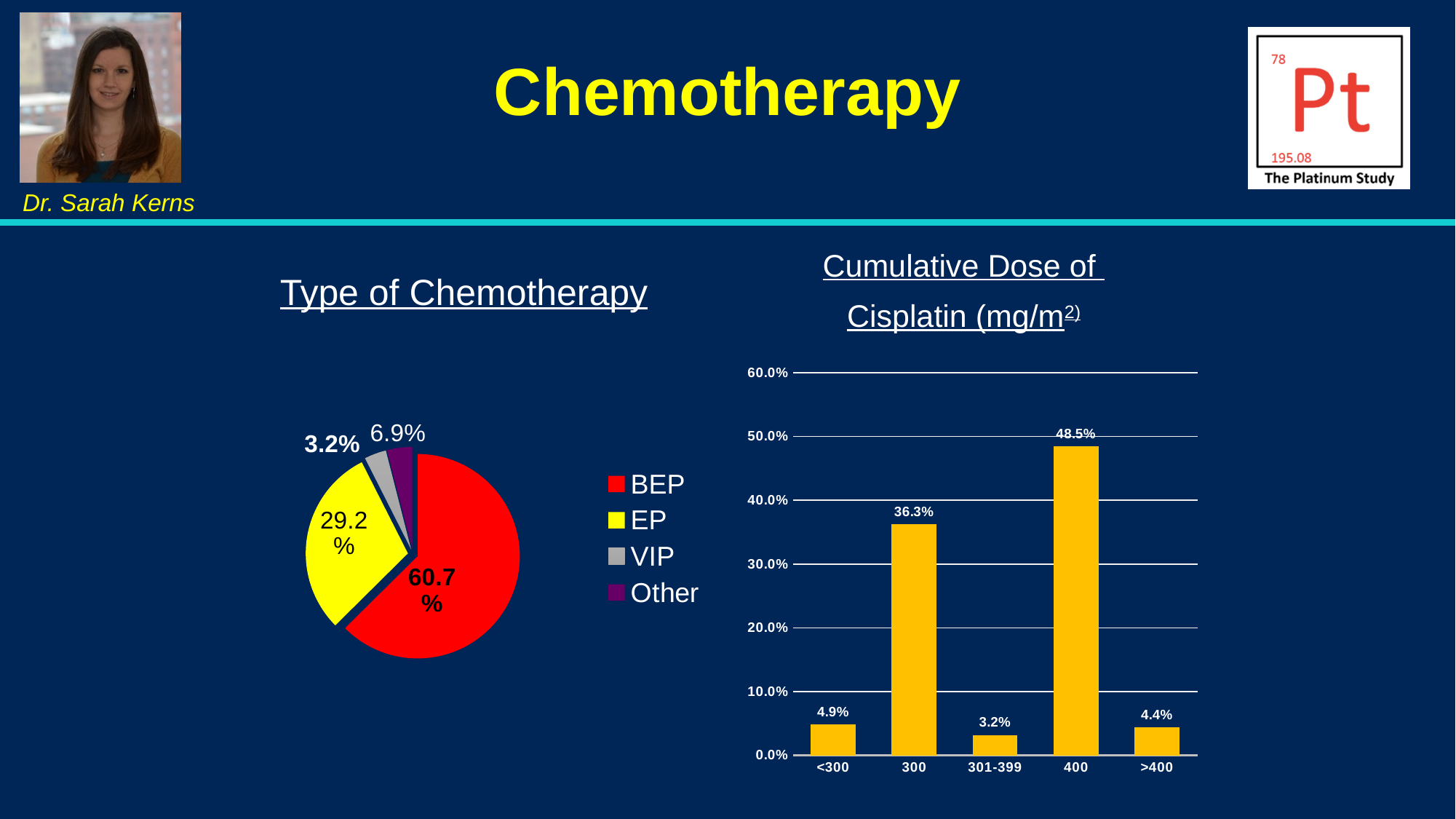
In the Type of Chemotherapy pie chart, how many categories does the legend list? 4 What kind of chart is the Cumulative Dose of Cisplatin chart? Bar chart In the Cumulative Dose of Cisplatin chart, what is the difference between the values for 400 and 300? 12.2% In the Type of Chemotherapy pie chart, what share does EP have? 29.2% In the Cumulative Dose of Cisplatin chart, which category has the lowest value? 301-399 In the Cumulative Dose of Cisplatin chart, how many categories are shown on the x axis? 5 In the Cumulative Dose of Cisplatin chart, what is the value for the <300 category? 4.9% In the Cumulative Dose of Cisplatin chart, what is the value for the 400 category? 48.5% In the Type of Chemotherapy pie chart, which category has the smallest slice? VIP In the Type of Chemotherapy pie chart, what colour is the Other slice? Purple In the Type of Chemotherapy pie chart, what share does BEP have? 60.7% In the Cumulative Dose of Cisplatin chart, which category has the highest value? 400